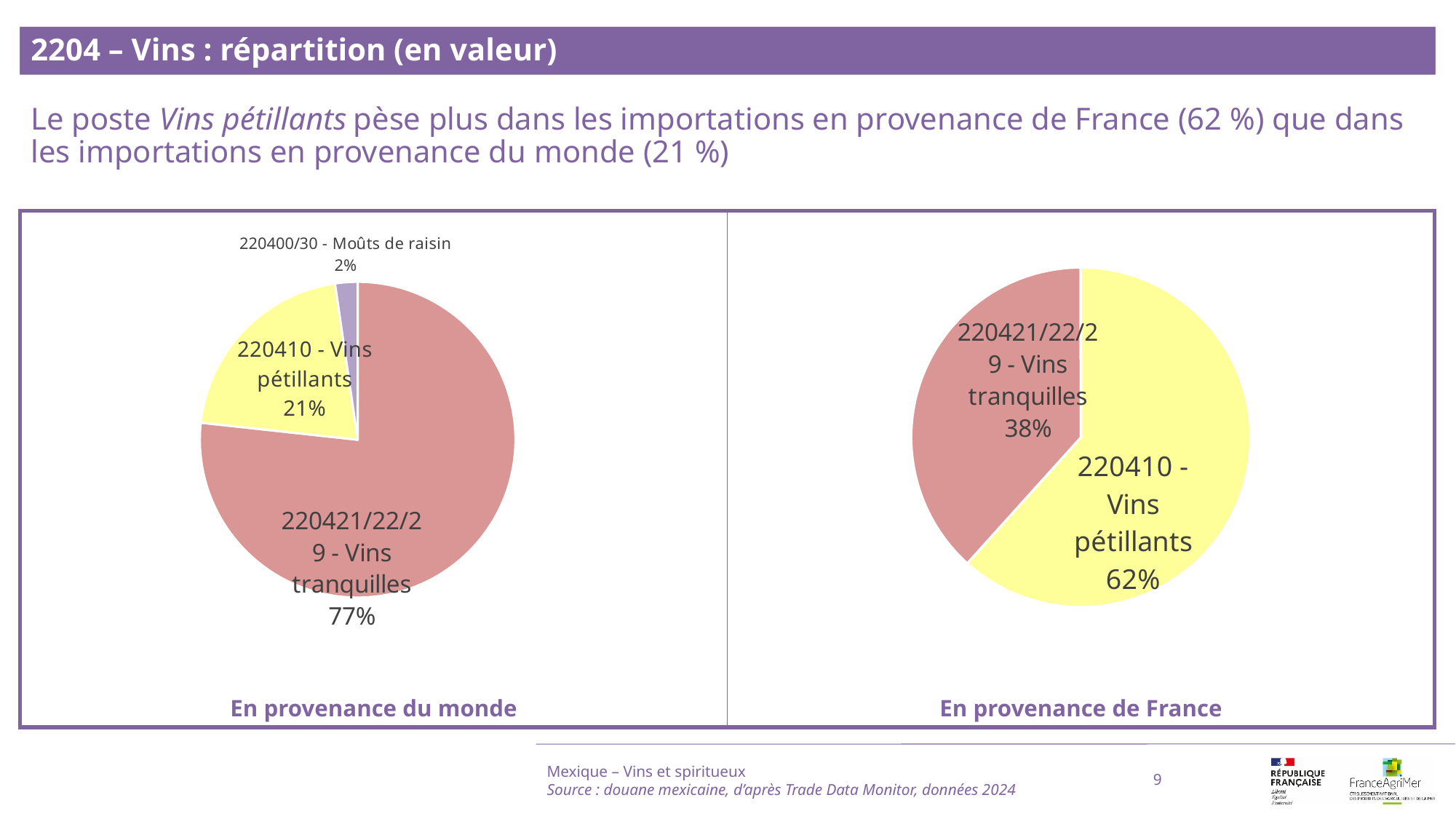
How many slices does the 'En provenance de France' pie chart have? 2 In the 'En provenance du monde' chart, what share does 220400/30 - Moûts de raisin have? 2% In the 'En provenance de France' chart, what share does 220410 - Vins pétillants have? 62% In the 'En provenance de France' chart, which category has the largest slice? 220410 - Vins pétillants In the 'En provenance du monde' chart, what share does 220421/22/29 - Vins tranquilles have? 77% In the 'En provenance de France' chart, what is the difference in percentage points between Vins pétillants and Vins tranquilles? 24 percentage points What type of chart is used in the 'En provenance de France' panel? Pie chart In the 'En provenance du monde' chart, which category has the largest slice? 220421/22/29 - Vins tranquilles In the 'En provenance du monde' chart, which category has the smallest slice? 220400/30 - Moûts de raisin How many slices does the 'En provenance du monde' pie chart have? 3